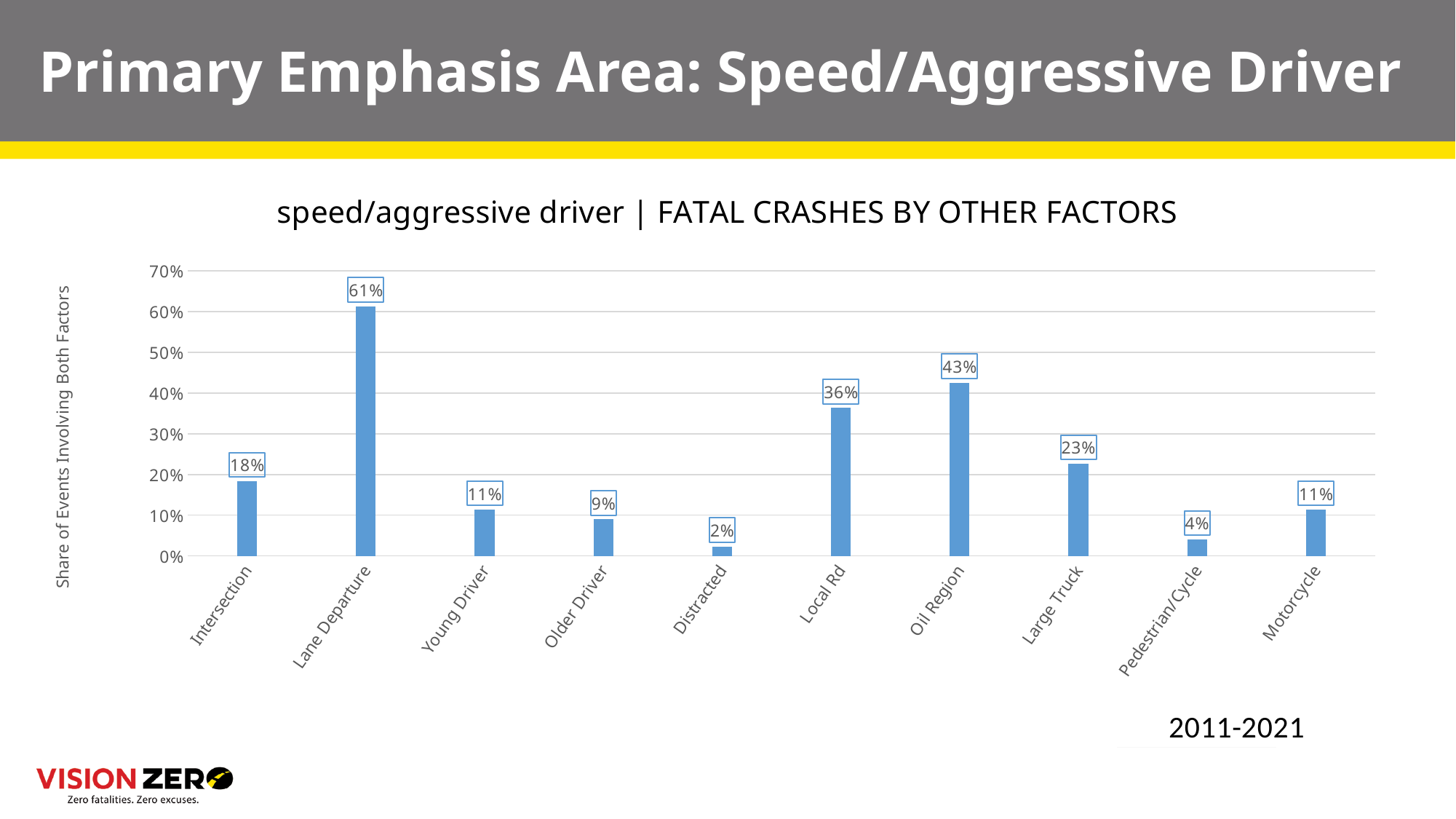
What kind of chart is shown on the slide? bar chart Which category has the highest value? Lane Departure What is the value for Oil Region? 43% What is the label of the y axis? Share of Events Involving Both Factors What is the title of the chart? speed/aggressive driver | FATAL CRASHES BY OTHER FACTORS Which is larger, the value for Intersection or the value for Large Truck? Large Truck Is the value for Local Rd greater or less than 30%? greater What is the value for Pedestrian/Cycle? 4% Which category has the lowest value? Distracted What is the difference between the values for Oil Region and Local Rd? 7% How many categories are shown on the x axis? 10 What is the value for Lane Departure? 61%